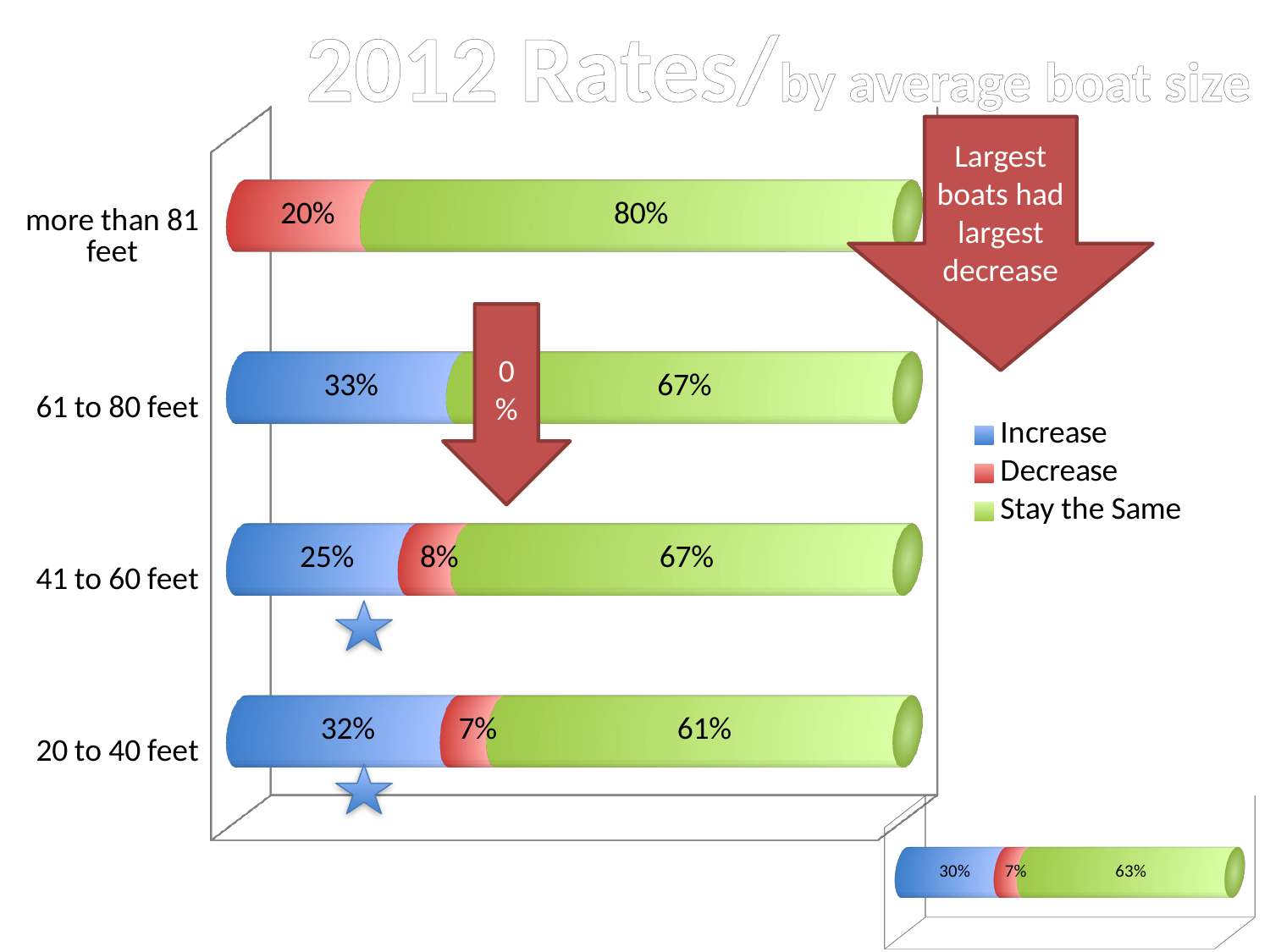
What is the Decrease value for the more than 81 feet category? 20% What is the Stay the Same value for the 20 to 40 feet category? 61% How many boat size categories are shown in the main chart? 4 Which boat size category has the lowest Decrease value? 61 to 80 feet Which boat size category has the highest Stay the Same value? more than 81 feet What is the Decrease value for the 41 to 60 feet category? 8% How many series does the legend list? 3 What is the Increase value for the 61 to 80 feet category? 33% Which has the larger Increase value, 41 to 60 feet or 20 to 40 feet? 20 to 40 feet What is the total of the stacked bar for the 41 to 60 feet category? 100% What kind of chart is the main chart on the slide? Stacked bar chart What is the difference between the Stay the Same value for more than 81 feet and for 20 to 40 feet? 19%